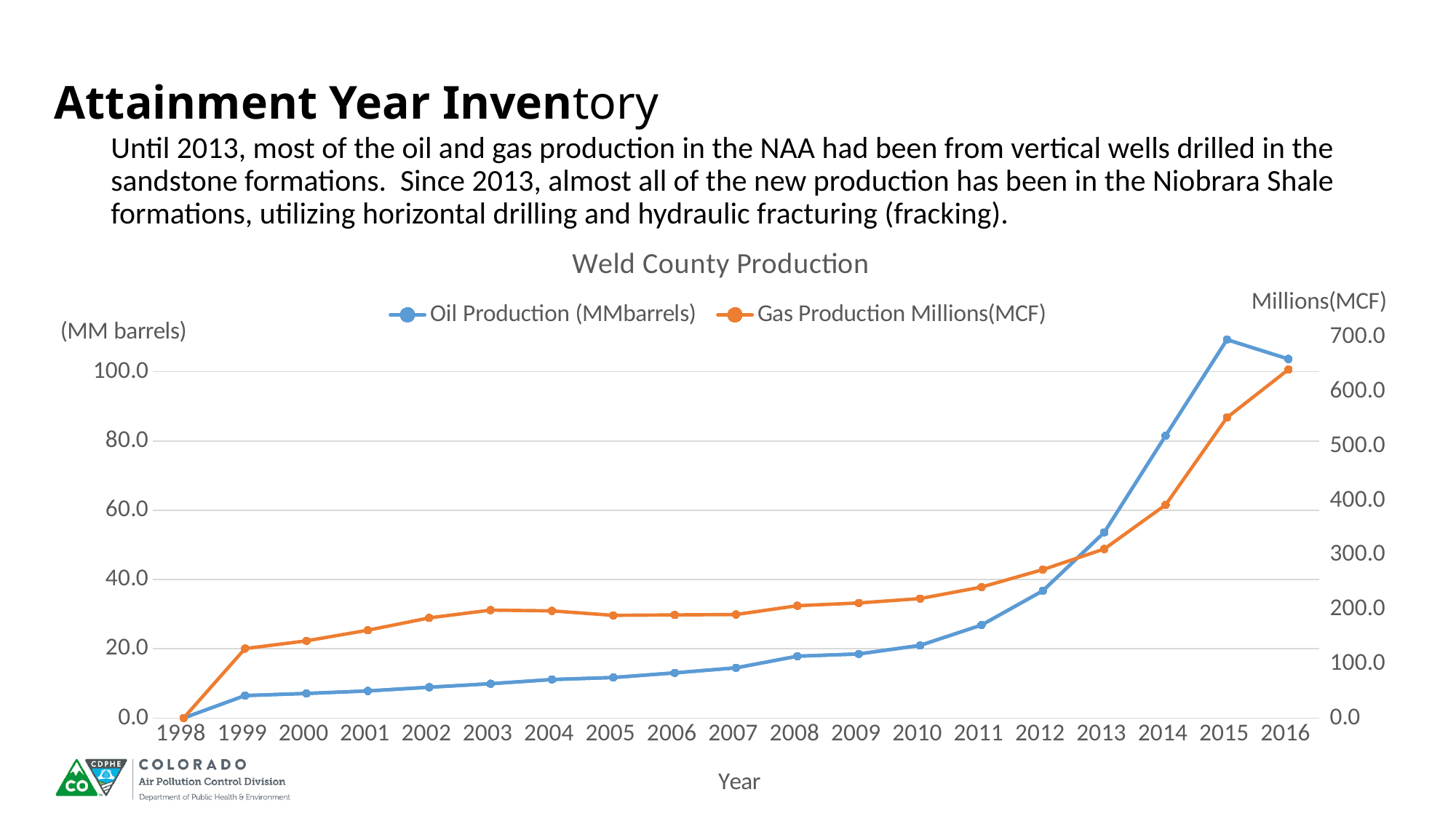
Is the Oil Production (MMbarrels) value for 2015 greater or less than 100.0? greater How many series does the legend list? 2 How many years are plotted along the x axis? 19 What is the Oil Production (MMbarrels) value for 1998? 0.0 In which year is Oil Production (MMbarrels) lowest? 1998 Is the Oil Production (MMbarrels) value for 2012 greater or less than 40.0? less Does Oil Production (MMbarrels) generally rise or fall from 1998 to 2015? rise What kind of chart is shown on the slide? line chart In which year is Gas Production Millions(MCF) highest? 2016 In which year is Oil Production (MMbarrels) highest? 2015 Is the Gas Production Millions(MCF) value for 2016 greater or less than 600.0? greater What is the title of the chart? Weld County Production